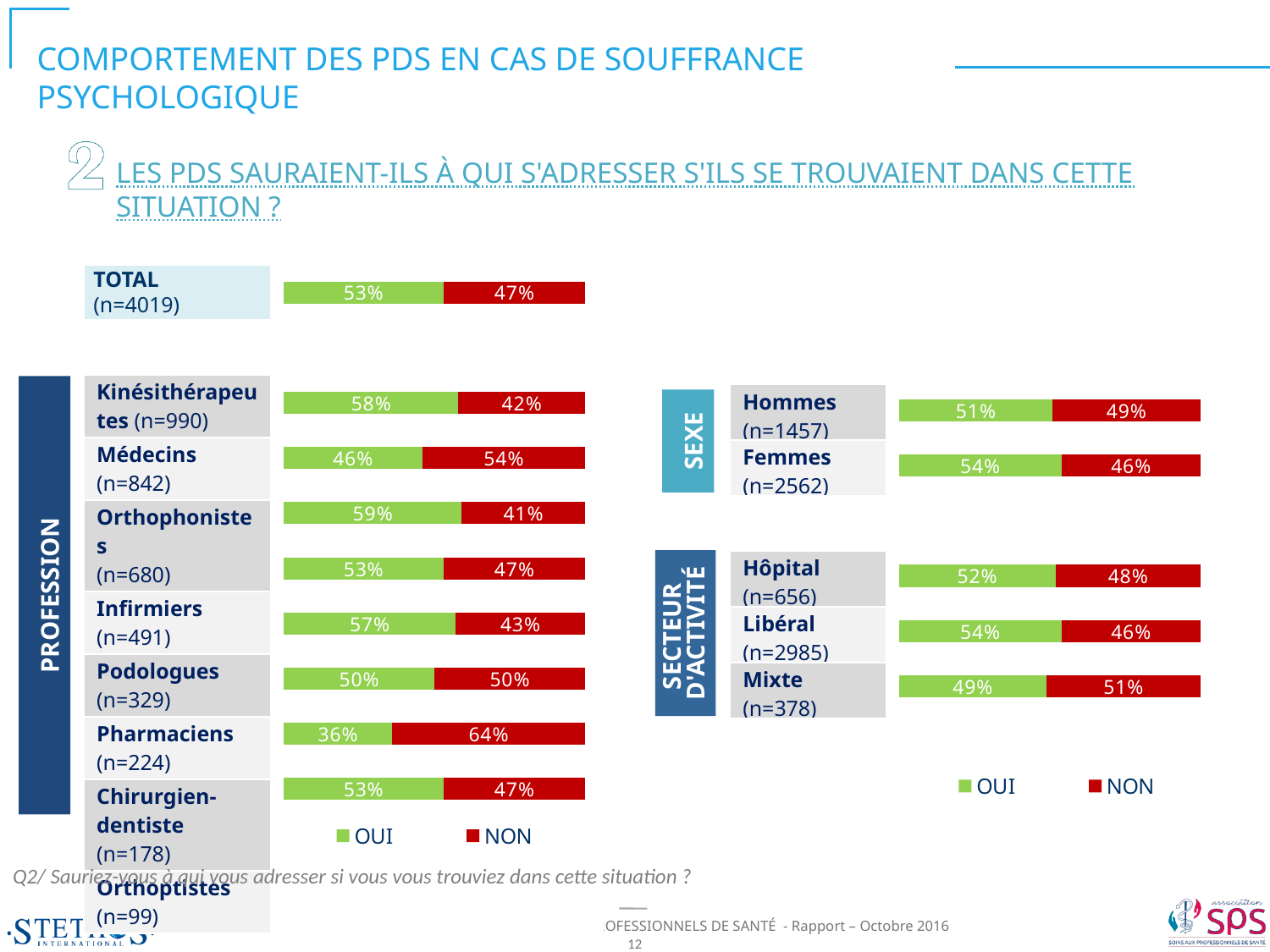
In the SECTEUR D'ACTIVITÉ chart, which sector has the lowest OUI percentage? Mixte In the SECTEUR D'ACTIVITÉ chart, how many sectors are shown? 3 In the SECTEUR D'ACTIVITÉ chart, what is the difference between the OUI percentages for Libéral and Mixte? 5% In the SECTEUR D'ACTIVITÉ chart, what is the OUI percentage for Libéral? 54% In the TOTAL bar, what percentage of respondents answered OUI? 53% In the SEXE chart, what is the NON percentage for Hommes? 49% In the PROFESSION chart, what is the NON percentage for Médecins? 54% In the SEXE chart, which group has the higher OUI percentage, Hommes or Femmes? Femmes In the PROFESSION chart, what is the OUI percentage for Kinésithérapeutes? 58% How many series does the legend of the SEXE chart list? 2 In the SEXE chart, what is the OUI percentage for Femmes? 54% In the TOTAL bar, what percentage answered NON? 47%